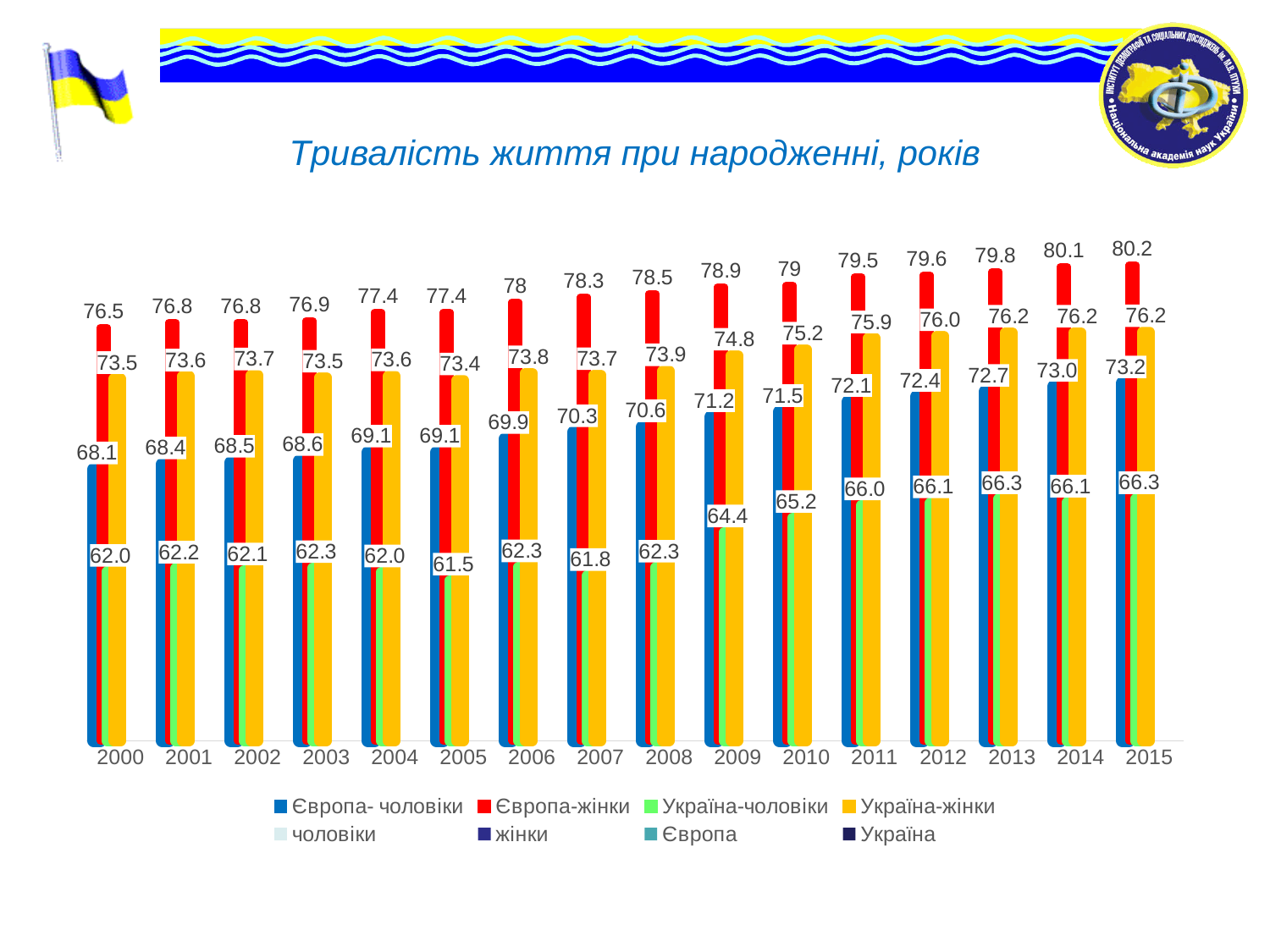
Which is larger in 2009: the value for Європа- чоловіки or the value for Україна-жінки? Україна-жінки What is the difference between Європа-жінки and Україна-жінки in 2000? 3.0 What is the value for Україна-жінки in 2010? 75.2 How many entries does the legend list? 8 What kind of chart is shown on the slide? bar chart What is the difference between Європа- чоловіки and Україна-чоловіки in 2015? 6.9 In which year is the value for Україна-чоловіки the lowest? 2005 How many years are shown on the x axis? 16 What is the value for Європа-жінки in 2015? 80.2 What is the value for Європа- чоловіки in 2008? 70.6 In which year is the value for Європа-жінки the highest? 2015 What is the value for Україна-чоловіки in 2005? 61.5